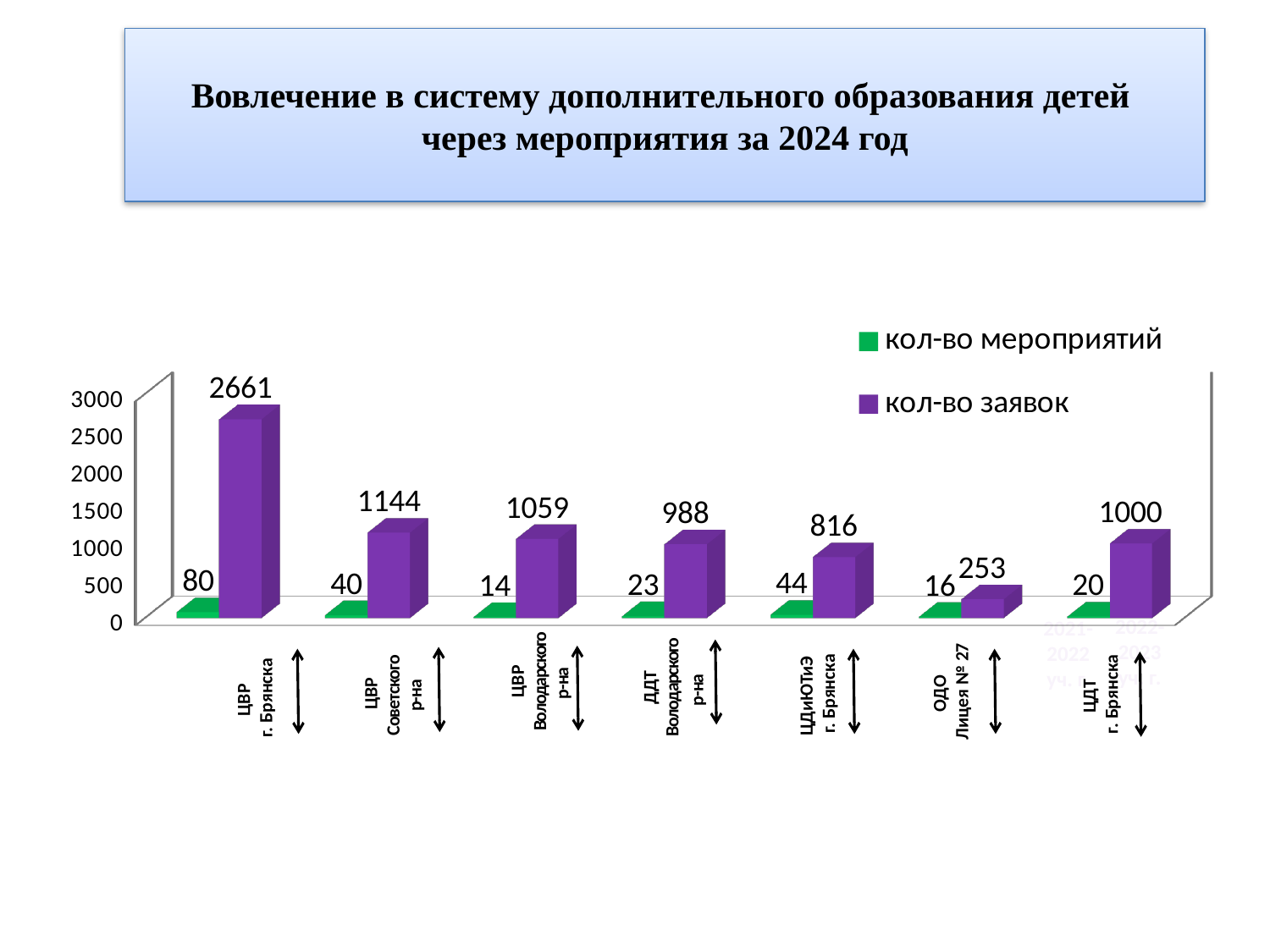
What is the value of кол-во заявок for ЦВР г. Брянска? 2661 Which category has the lowest value of кол-во мероприятий? ЦВР Володарского р-на What is the value of кол-во заявок for ОДО Лицея № 27? 253 How many categories are shown on the x axis of the chart? 7 Is the value of кол-во заявок for ЦДиЮТиЭ г. Брянска greater or less than 1000? less Which category has the highest value of кол-во заявок? ЦВР г. Брянска Which is larger: кол-во заявок for ДДТ Володарского р-на or for ЦДТ г. Брянска? ЦДТ г. Брянска How many series does the legend list? 2 What is the value of кол-во мероприятий for ЦДиЮТиЭ г. Брянска? 44 What kind of chart is shown on the slide? bar chart What is the difference between кол-во заявок for ЦВР Советского р-на and ЦВР Володарского р-на? 85 What colour represents кол-во мероприятий in the chart? green